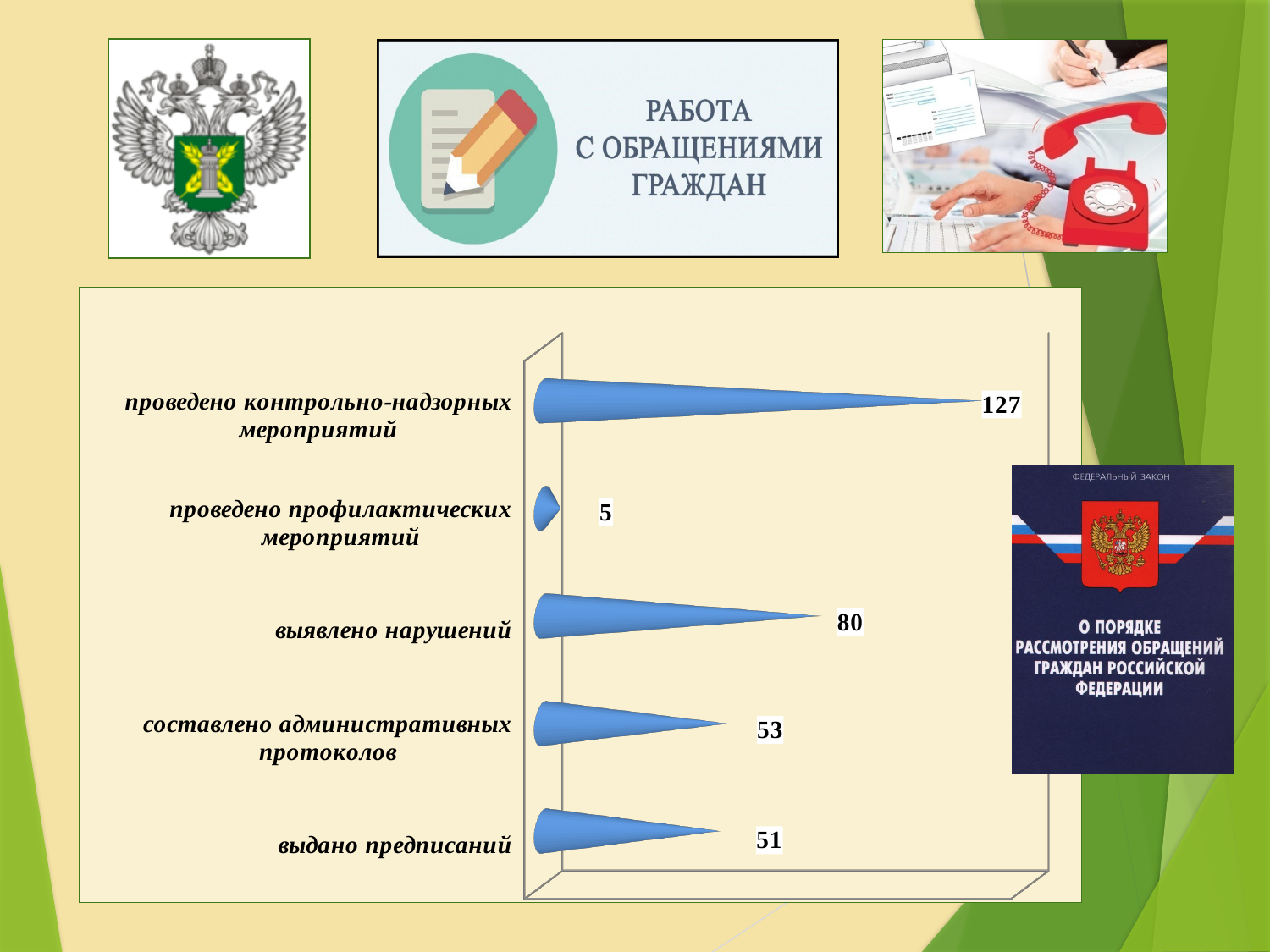
What value is shown for "составлено административных протоколов"? 53 How many categories are shown in the chart? 5 Which category has the highest value? проведено контрольно-надзорных мероприятий What is the difference between the values for "проведено контрольно-надзорных мероприятий" and "выявлено нарушений"? 47 Which is larger: the value for "выявлено нарушений" or the value for "составлено административных протоколов"? выявлено нарушений What value is shown for "выявлено нарушений"? 80 What value is shown for "проведено профилактических мероприятий"? 5 What value is shown for "выдано предписаний"? 51 What value is shown for "проведено контрольно-надзорных мероприятий"? 127 What kind of chart is shown on the slide? bar chart What is the difference between the values for "составлено административных протоколов" and "выдано предписаний"? 2 Which category has the lowest value? проведено профилактических мероприятий